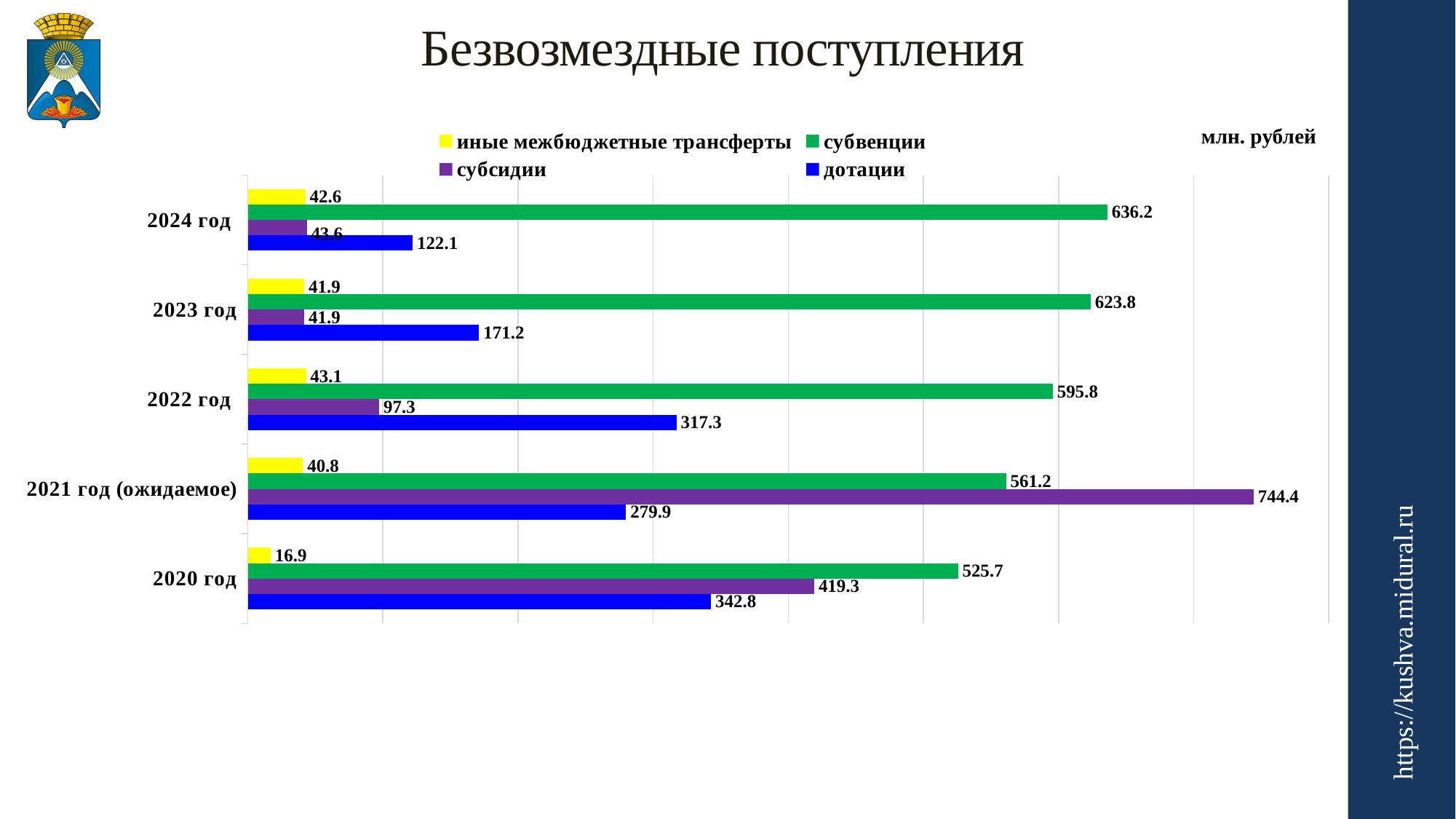
How many series does the legend list? 4 What is the value of субвенции for 2024 год? 636.2 Which is larger for 2021 год (ожидаемое): субсидии or субвенции? субсидии How many year categories are shown on the chart? 5 What is the value of субсидии for 2021 год (ожидаемое)? 744.4 In which year is the value of субвенции the highest? 2024 год What is the difference between дотации in 2020 год and дотации in 2024 год? 220.7 What is the value of дотации for 2022 год? 317.3 What unit of measurement is indicated on the chart? млн. рублей In which year is the value of иные межбюджетные трансферты the lowest? 2020 год Do the values of субвенции rise or fall from 2020 год to 2024 год? rise What type of chart is shown on the slide? bar chart